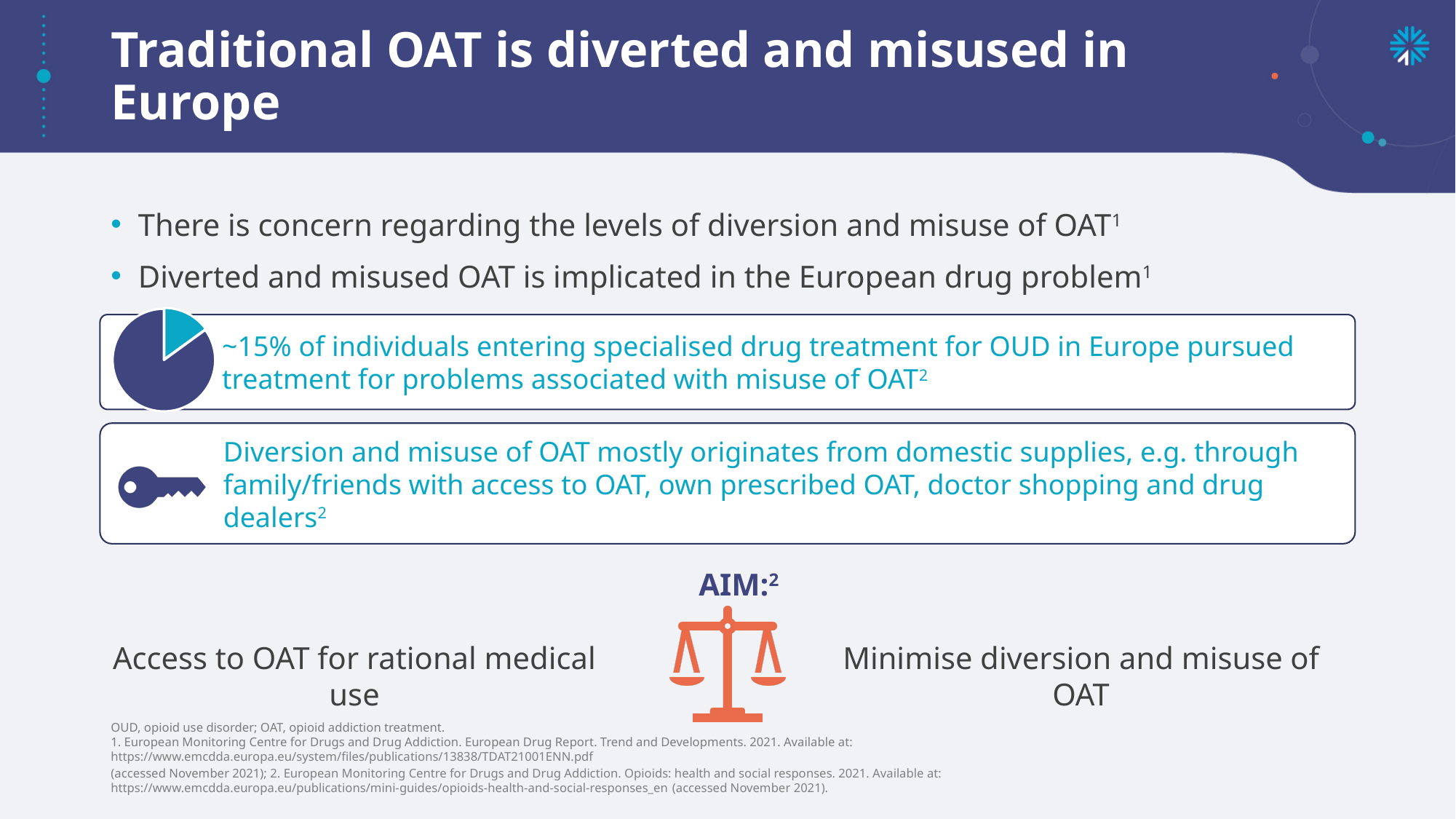
In the pie chart, which slice is larger: the dark blue slice or the light blue slice? the dark blue slice What colour is the small slice of the pie chart that represents individuals who pursued treatment for problems associated with misuse of OAT? light blue How many slices does the pie chart on the slide have? 2 What kind of chart is shown next to the text about individuals entering specialised drug treatment? pie chart In the pie chart, which slice is the smallest? the light blue slice Does the pie chart on the slide have a legend? No